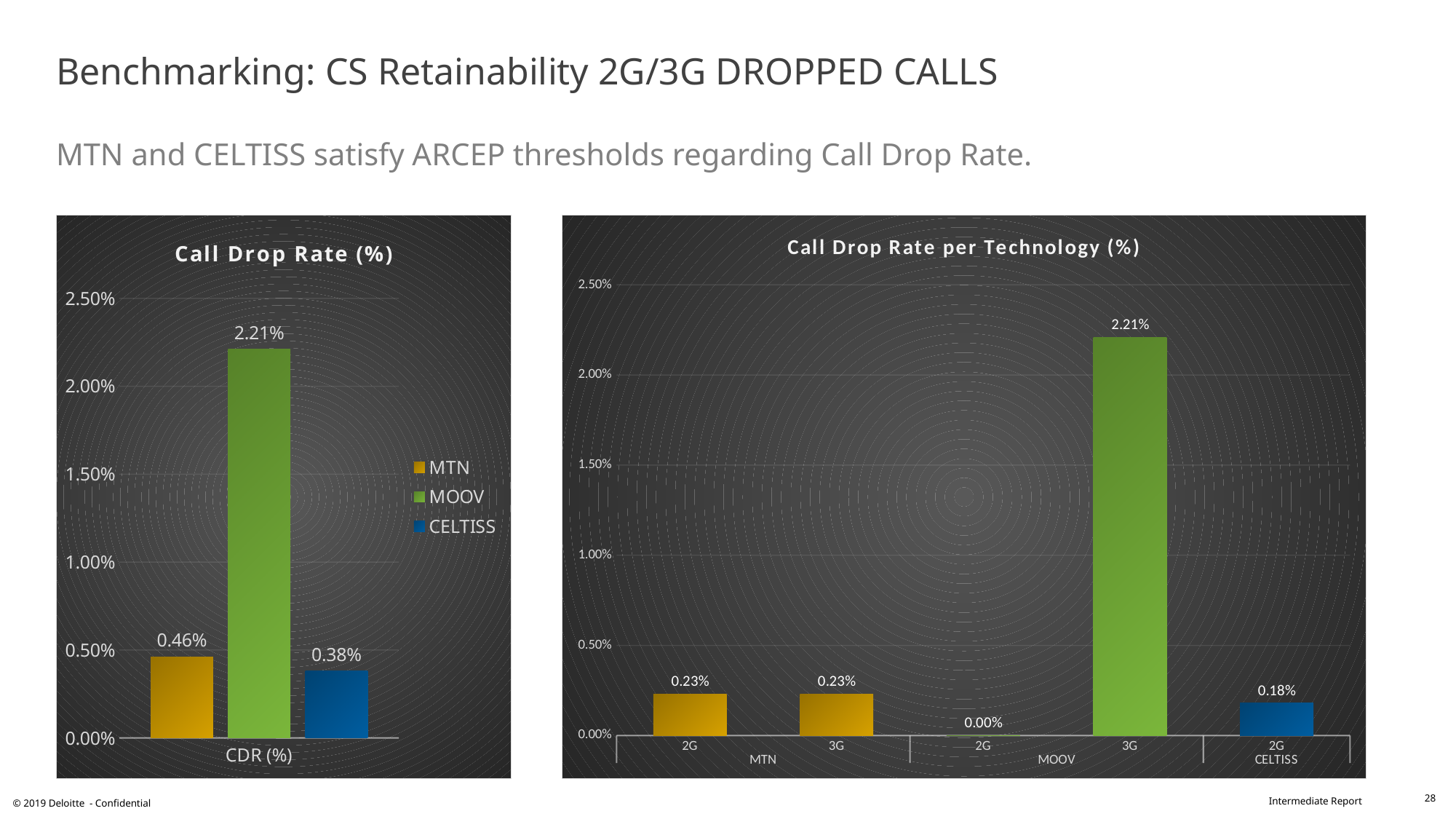
In the 'Call Drop Rate (%)' chart, which operator has the lowest call drop rate? CELTISS In the 'Call Drop Rate (%)' chart, how many series does the legend list? 3 In the 'Call Drop Rate per Technology (%)' chart, what is the value for MOOV 3G? 2.21% In the 'Call Drop Rate per Technology (%)' chart, which of MTN 2G or CELTISS 2G has the larger value? MTN 2G What kind of chart is the 'Call Drop Rate per Technology (%)' chart? Bar chart In the 'Call Drop Rate (%)' chart, what is the value for MOOV? 2.21% In the 'Call Drop Rate (%)' chart, what is the difference between the MTN and CELTISS values? 0.08% In the 'Call Drop Rate (%)' chart, what is the value for MTN? 0.46% In the 'Call Drop Rate per Technology (%)' chart, what is the value for MOOV 2G? 0.00% In the 'Call Drop Rate (%)' chart, is the value for MOOV greater or less than 2.00%? greater In the 'Call Drop Rate per Technology (%)' chart, how many bars are plotted? 5 In the 'Call Drop Rate per Technology (%)' chart, what is the value for CELTISS 2G? 0.18%